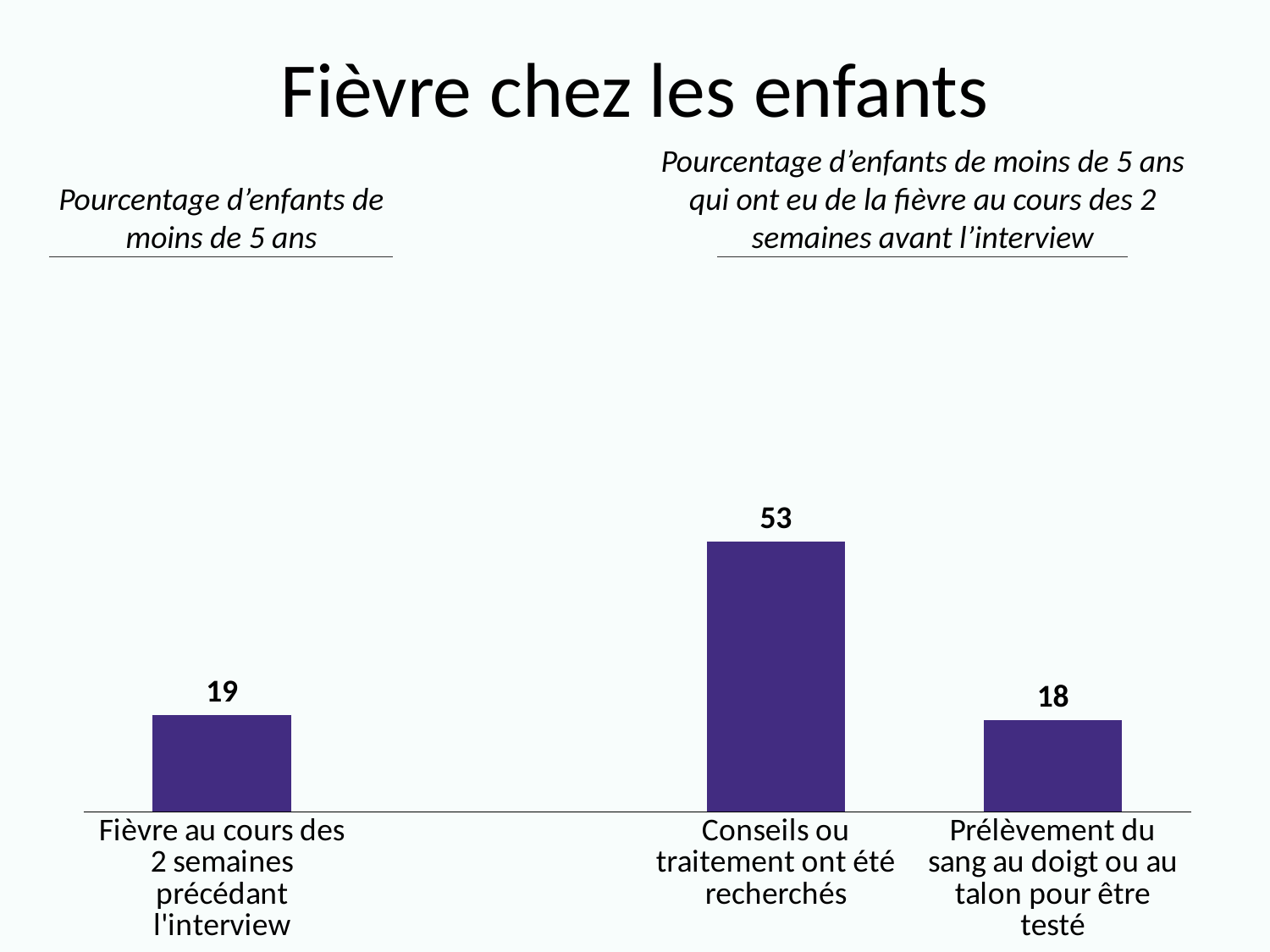
What value is shown for "Fièvre au cours des 2 semaines précédant l'interview"? 19 Which is larger: the value for "Conseils ou traitement ont été recherchés" or the value for "Fièvre au cours des 2 semaines précédant l'interview"? Conseils ou traitement ont été recherchés What is the difference between the value for "Conseils ou traitement ont été recherchés" and the value for "Prélèvement du sang au doigt ou au talon pour être testé"? 35 What is the difference between the value for "Fièvre au cours des 2 semaines précédant l'interview" and the value for "Prélèvement du sang au doigt ou au talon pour être testé"? 1 Which category has the highest value? Conseils ou traitement ont été recherchés What value is shown for "Conseils ou traitement ont été recherchés"? 53 What kind of chart is shown on the slide? Bar chart Which category has the lowest value? Prélèvement du sang au doigt ou au talon pour être testé What value is shown for "Prélèvement du sang au doigt ou au talon pour être testé"? 18 What colour are the bars in the chart? Purple How many bars are plotted on the chart? 3 What is the title of the slide? Fièvre chez les enfants